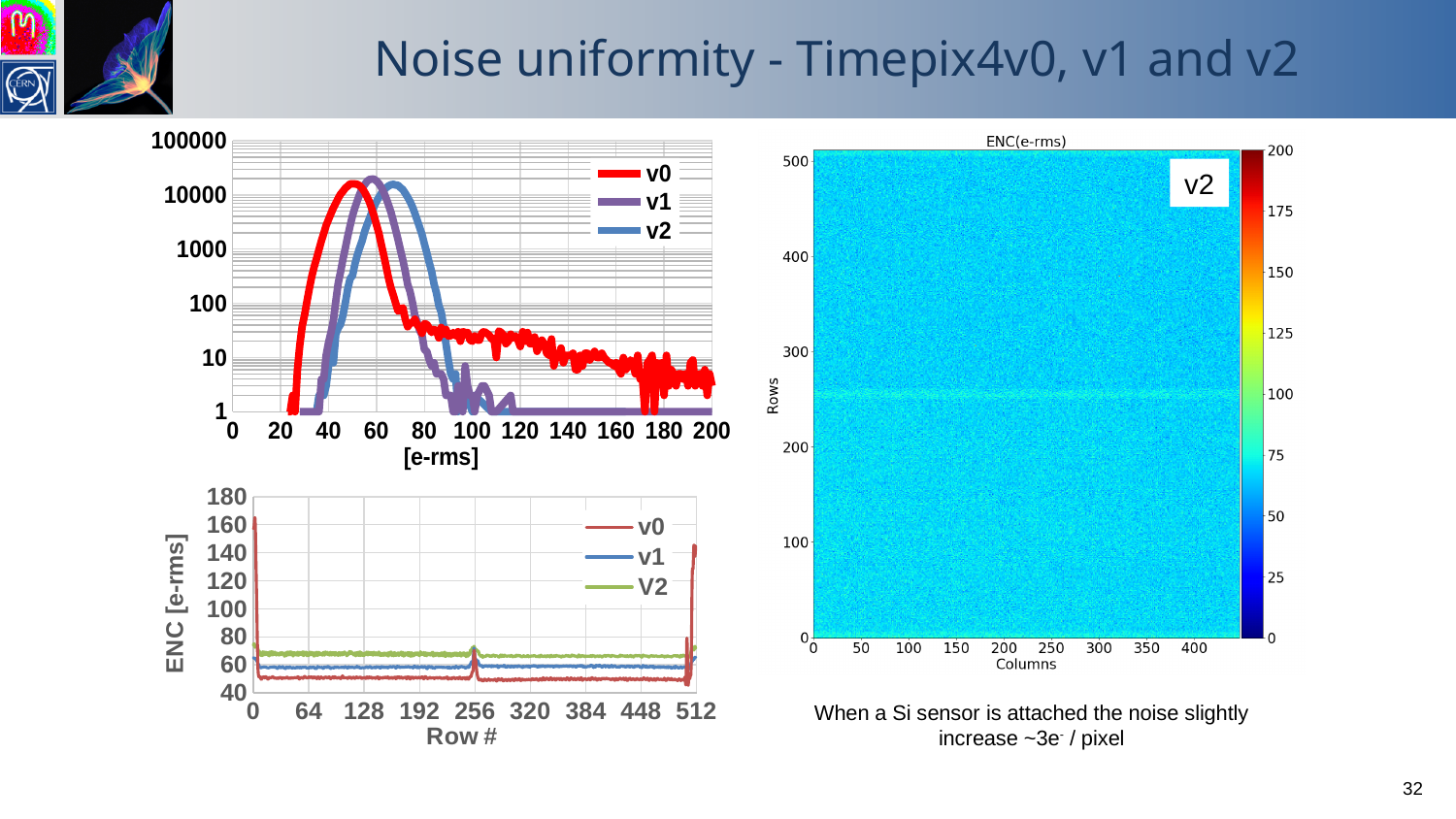
In the top-left chart, how many series does the legend list? 3 In the right-hand chart titled ENC(e-rms), what is the maximum value on the colour scale? 200 In the bottom-left chart (ENC vs Row #), how many series does the legend list? 3 In the top-left chart, is the peak value of the v0 series greater or less than 1000? greater In the bottom-left chart (ENC vs Row #), which series has the highest ENC across most rows? V2 In the top-left chart, what is the x-axis label? [e-rms] In the top-left chart, which series has its peak at the highest e-rms value? v2 In the top-left chart, which series has its peak at the lowest e-rms value? v0 In the top-left chart, which series extends furthest along the x axis, with counts still visible near 200 e-rms? v0 In the bottom-left chart (ENC vs Row #), which series has the lowest ENC across most rows? v0 In the bottom-left chart (ENC vs Row #), is the ENC of the v0 series at row 128 greater or less than 60? less In the bottom-left chart (ENC vs Row #), what is the largest value shown on the x axis? 512